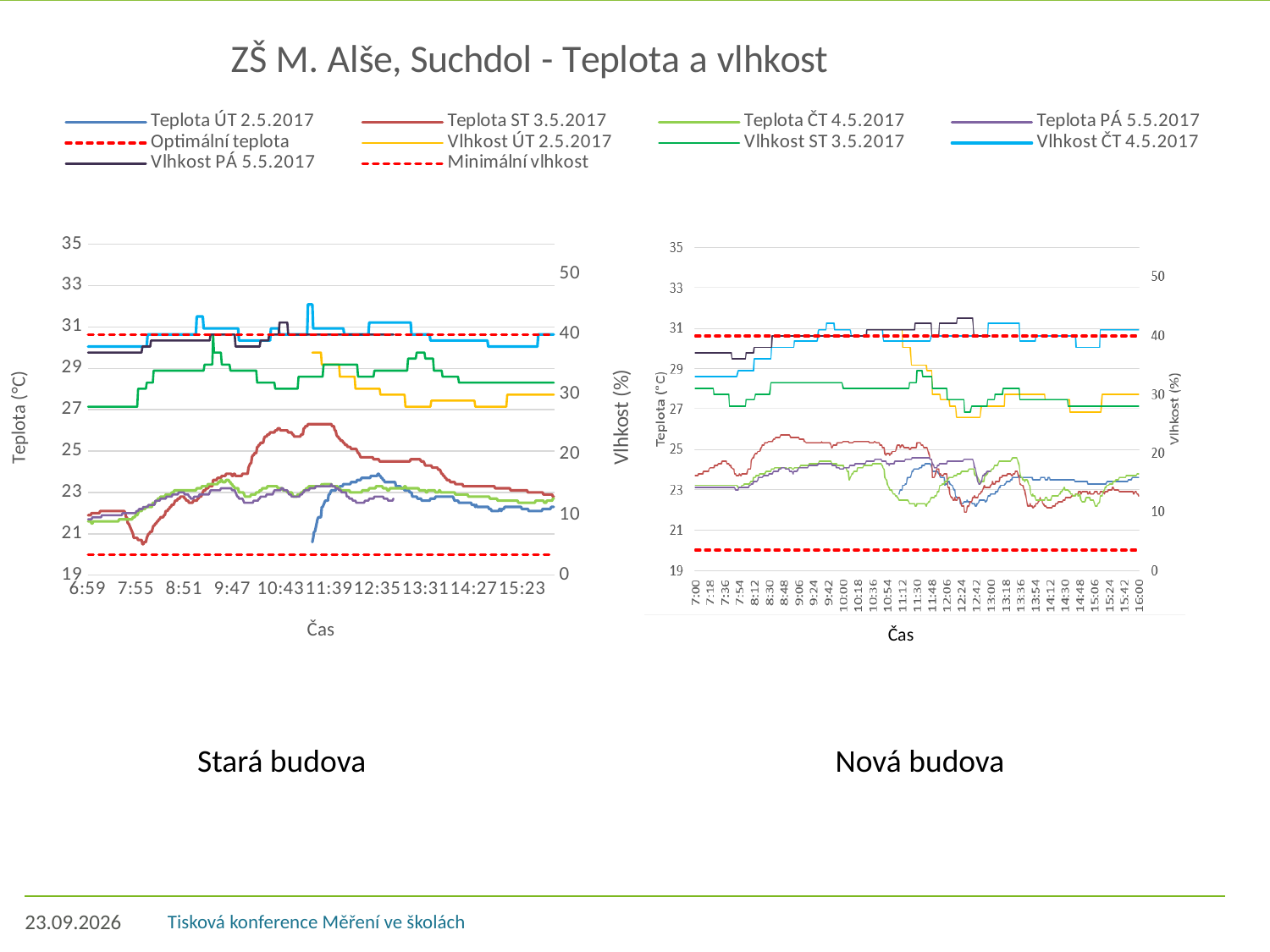
How many charts are shown on the slide? 2 What kind of chart is used for the Stará budova chart? line chart In the Stará budova chart, which temperature series reaches the highest value? Teplota ST 3.5.2017 In the Stará budova chart, is the highest value of Vlhkost ČT 4.5.2017 greater or less than 40? greater In the Stará budova chart, does Vlhkost ÚT 2.5.2017 rise or fall overall from its start to the end of the day? fall In the Nová budova chart, is the lowest value of Vlhkost ÚT 2.5.2017 greater or less than 30? less How many series does the legend list? 10 What is the title of the left vertical axis on the Stará budova chart? Teplota (°C) In the Stará budova chart, is the highest value of Teplota ST 3.5.2017 greater or less than 25? greater What is the title of the horizontal axis on the Nová budova chart? Čas